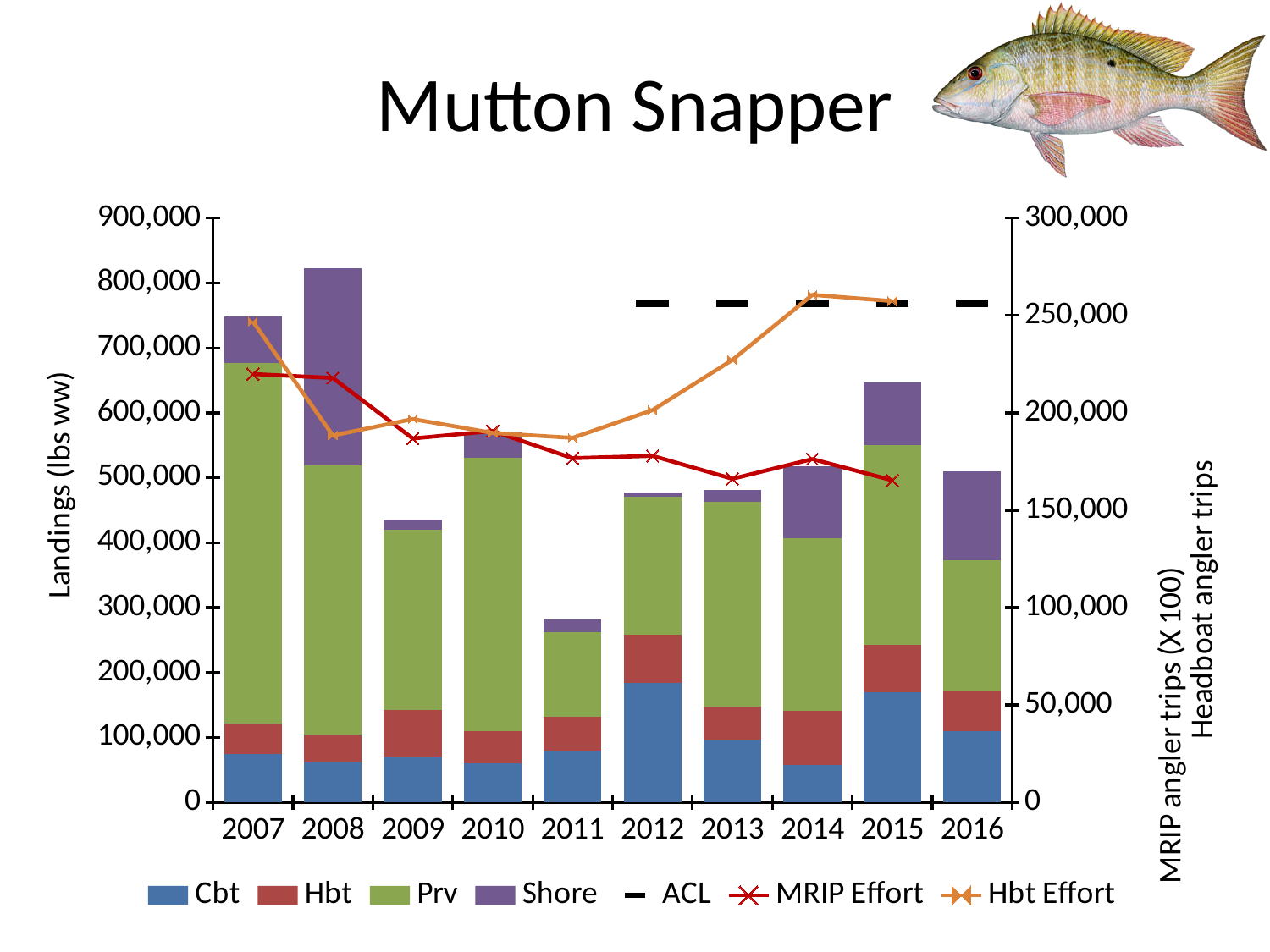
How many series does the legend list? 7 Is the MRIP Effort value for 2015 greater or less than 200,000 on the right axis? less Which year has the lowest total landings bar? 2011 Is the Hbt Effort value for 2014 greater or less than 250,000 on the right axis? greater Which year has the highest total landings bar? 2008 Which is larger, the total landings bar for 2007 or for 2009? 2007 Is the total landings bar for 2008 greater or less than 800,000? greater Does the MRIP Effort line generally rise or fall from 2007 to 2015? fall Which year has the highest Hbt Effort value? 2014 What kind of chart is shown on the slide? A combined stacked bar and line chart How many years are shown on the x axis of the chart? 10